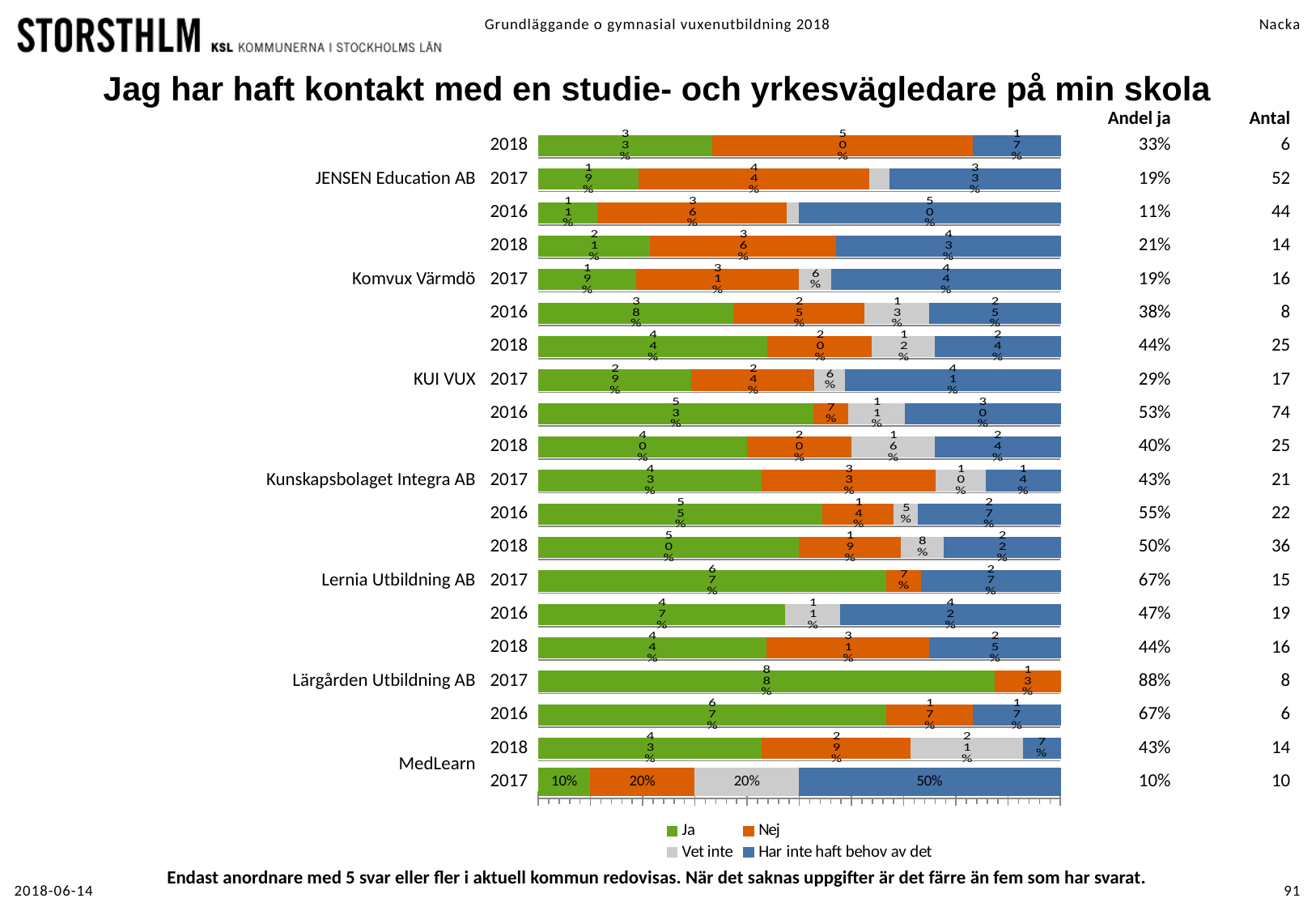
How many series does the legend list? 4 Which provider and year has the lowest 'Ja' share? MedLearn 2017 What kind of chart is shown on the slide? Stacked bar chart How many bars are plotted in the chart? 20 Which legend entry is shown in green? Ja What is the difference in 'Ja' share between Lärgården Utbildning AB 2017 and Lärgården Utbildning AB 2016? 21 percentage points What is the 'Nej' share for MedLearn in 2017? 20% What is the 'Ja' share for Lärgården Utbildning AB in 2017? 88% What is the 'Har inte haft behov av det' share for MedLearn in 2017? 50% What is the 'Ja' share for JENSEN Education AB in 2016? 11% Which has a larger 'Ja' share: Lernia Utbildning AB 2017 or KUI VUX 2016? Lernia Utbildning AB 2017 Which provider and year has the highest 'Ja' share? Lärgården Utbildning AB 2017